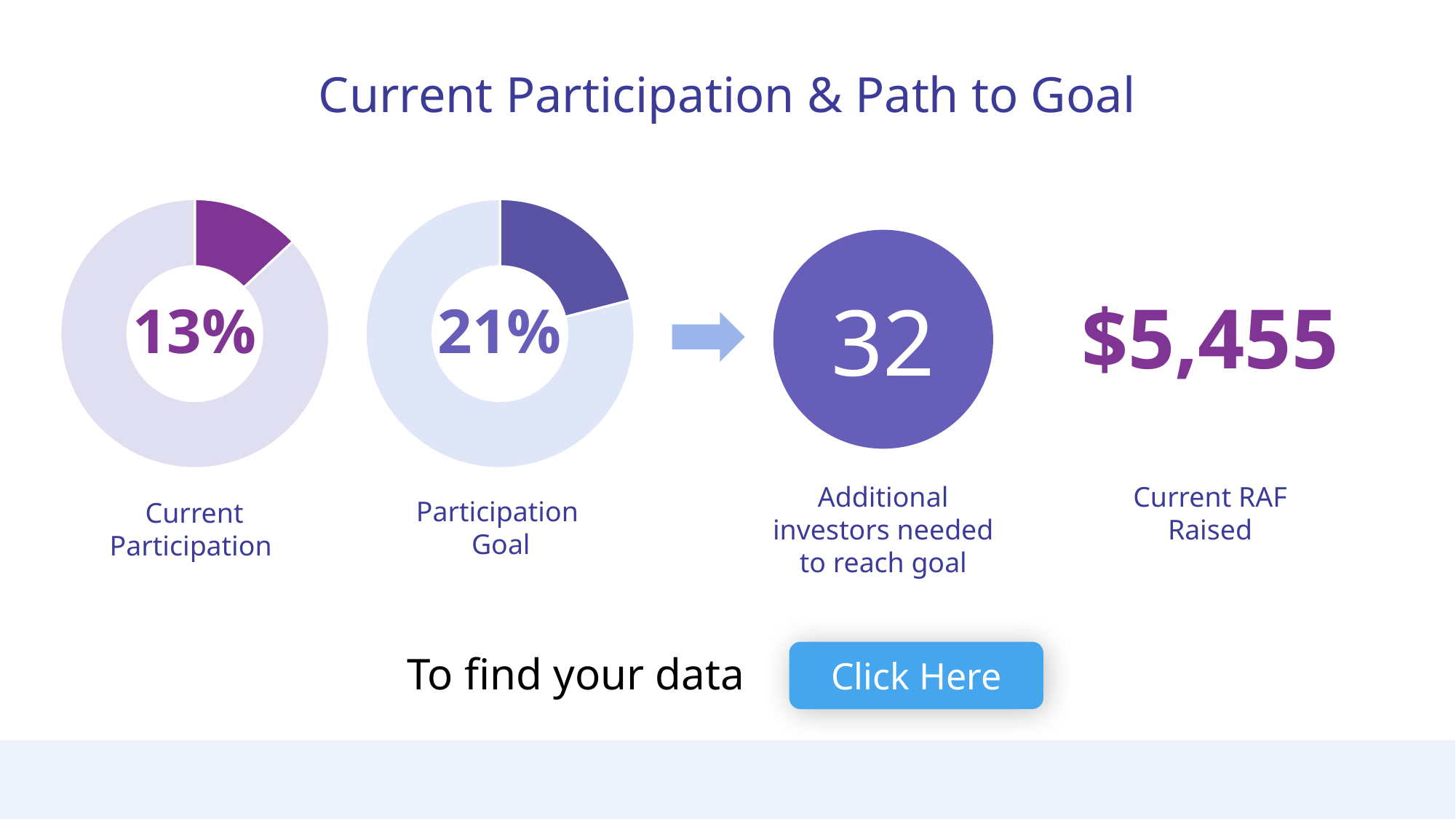
What kind of chart is used to show Current Participation? Donut chart What is the difference between the Participation Goal value and the Current Participation value? 8% What value is shown in the centre of the Participation Goal donut chart? 21% How many donut charts are on the slide? 2 Which is larger, the Current Participation value or the Participation Goal value? Participation Goal What value is shown in the centre of the Current Participation donut chart? 13% In the Participation Goal donut chart, what share of the ring is filled by the highlighted slice? 21% What kind of chart is used to show Participation Goal? Donut chart What is the label below the left donut chart? Current Participation In the Current Participation donut chart, what share of the ring is filled by the highlighted slice? 13% What is the title of the slide containing the donut charts? Current Participation & Path to Goal